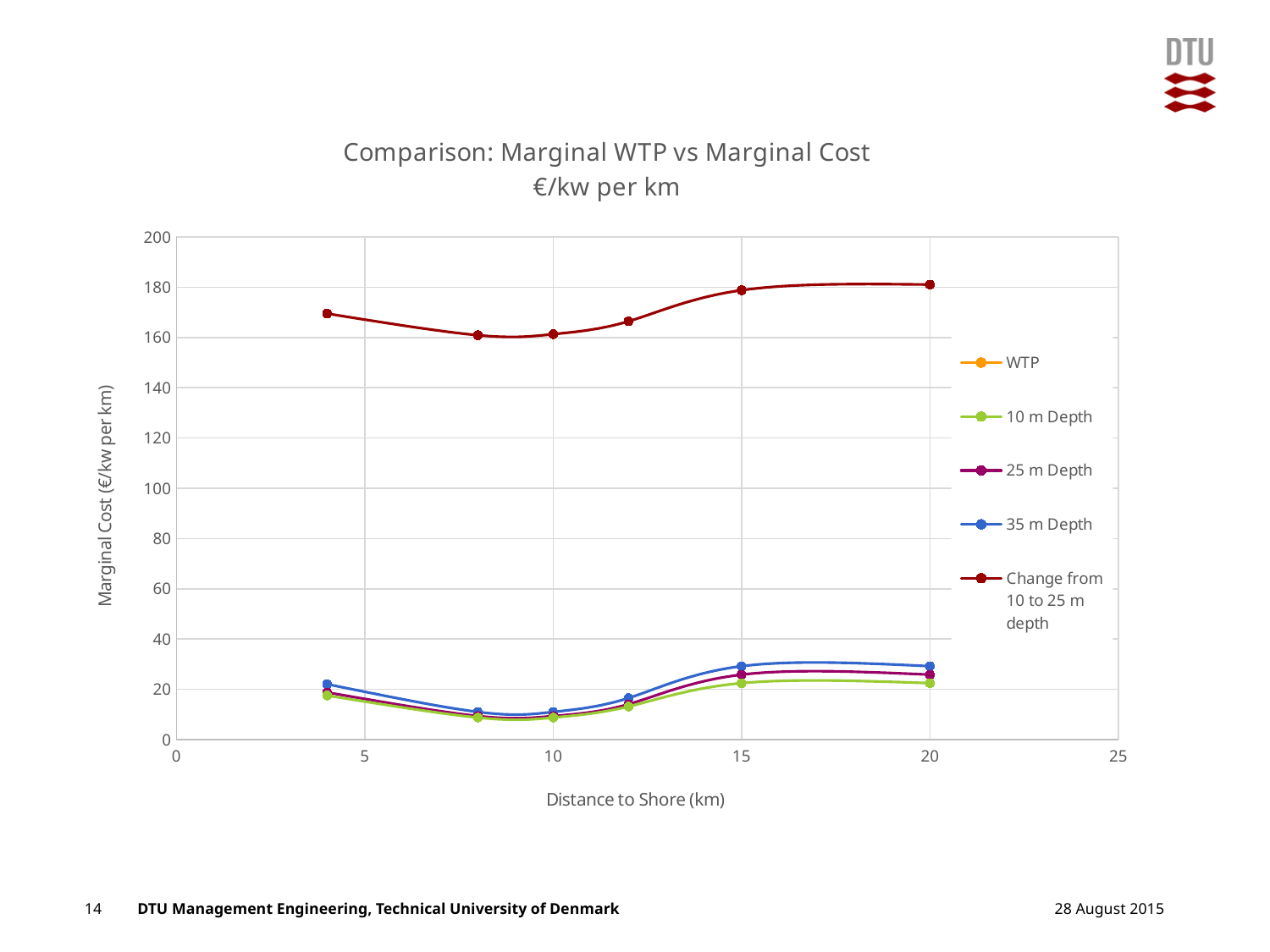
What is the title of the x axis? Distance to Shore (km) Is the value of the 10 m Depth series at 8 km greater or less than 20? less What kind of chart is shown on the slide? Line chart Does the Change from 10 to 25 m depth series rise or fall between 12 km and 20 km? Rise What is the title of the y axis? Marginal Cost (€/kw per km) How many series does the legend list? 5 Is the value of the 35 m Depth series at 15 km greater or less than 20? greater At 15 km, which is larger: the 35 m Depth value or the 10 m Depth value? 35 m Depth Which series has the highest values across the chart? Change from 10 to 25 m depth Is the value of the Change from 10 to 25 m depth series at 10 km greater or less than 180? less How many data points are plotted for the 35 m Depth series? 6